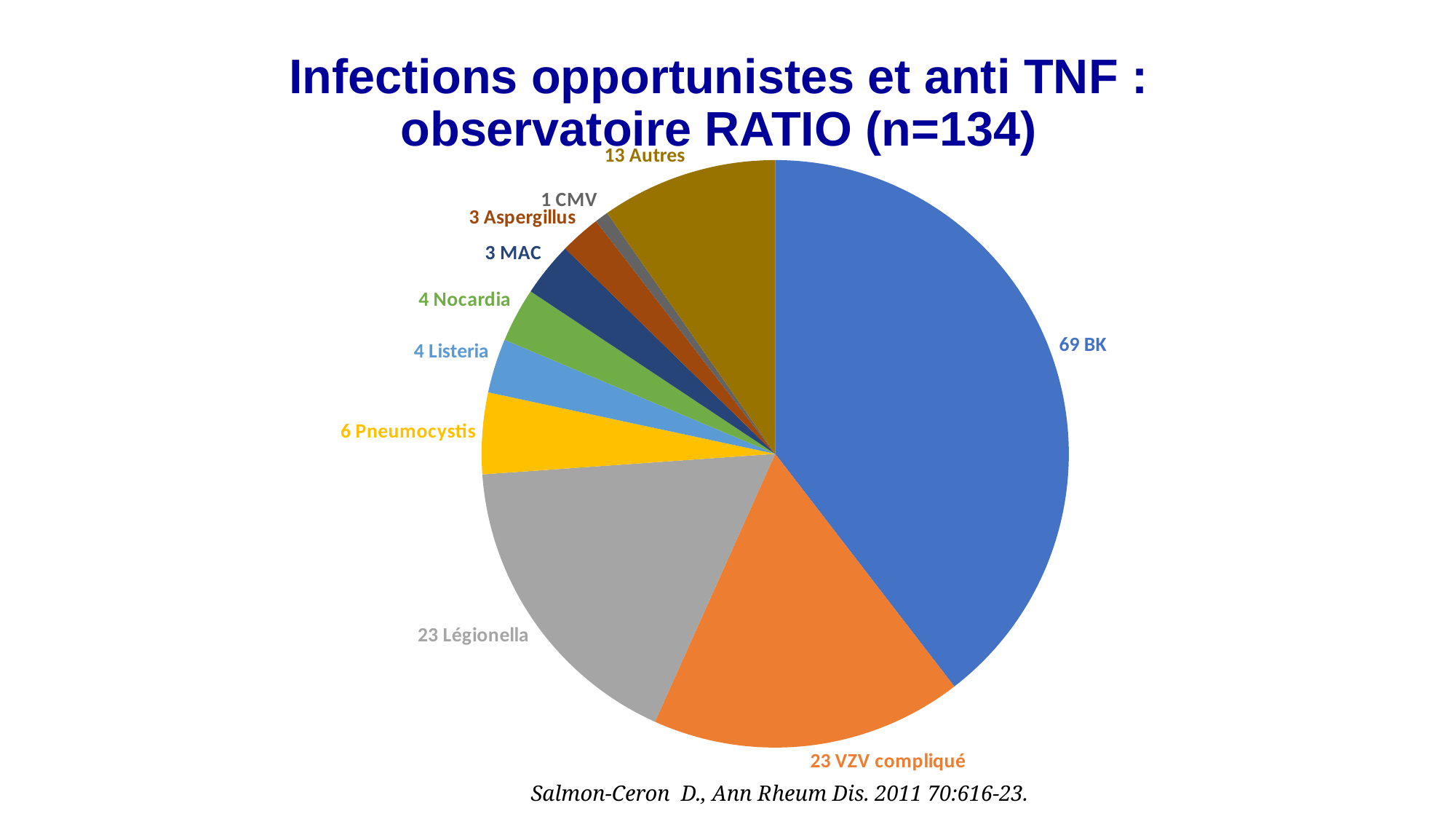
Which is larger, the value for Autres or the value for Pneumocystis? Autres Which category has the smallest slice? CMV What is the value for Légionella? 23 What kind of chart is shown on the slide? pie chart What is the value for CMV? 1 What is the difference between the values for BK and VZV compliqué? 46 What is the title of the chart? Infections opportunistes et anti TNF : observatoire RATIO (n=134) What is the value for Pneumocystis? 6 What is the value for BK? 69 Which category has the largest slice? BK What is the difference between the values for Autres and Nocardia? 9 How many slices does the pie chart have? 10